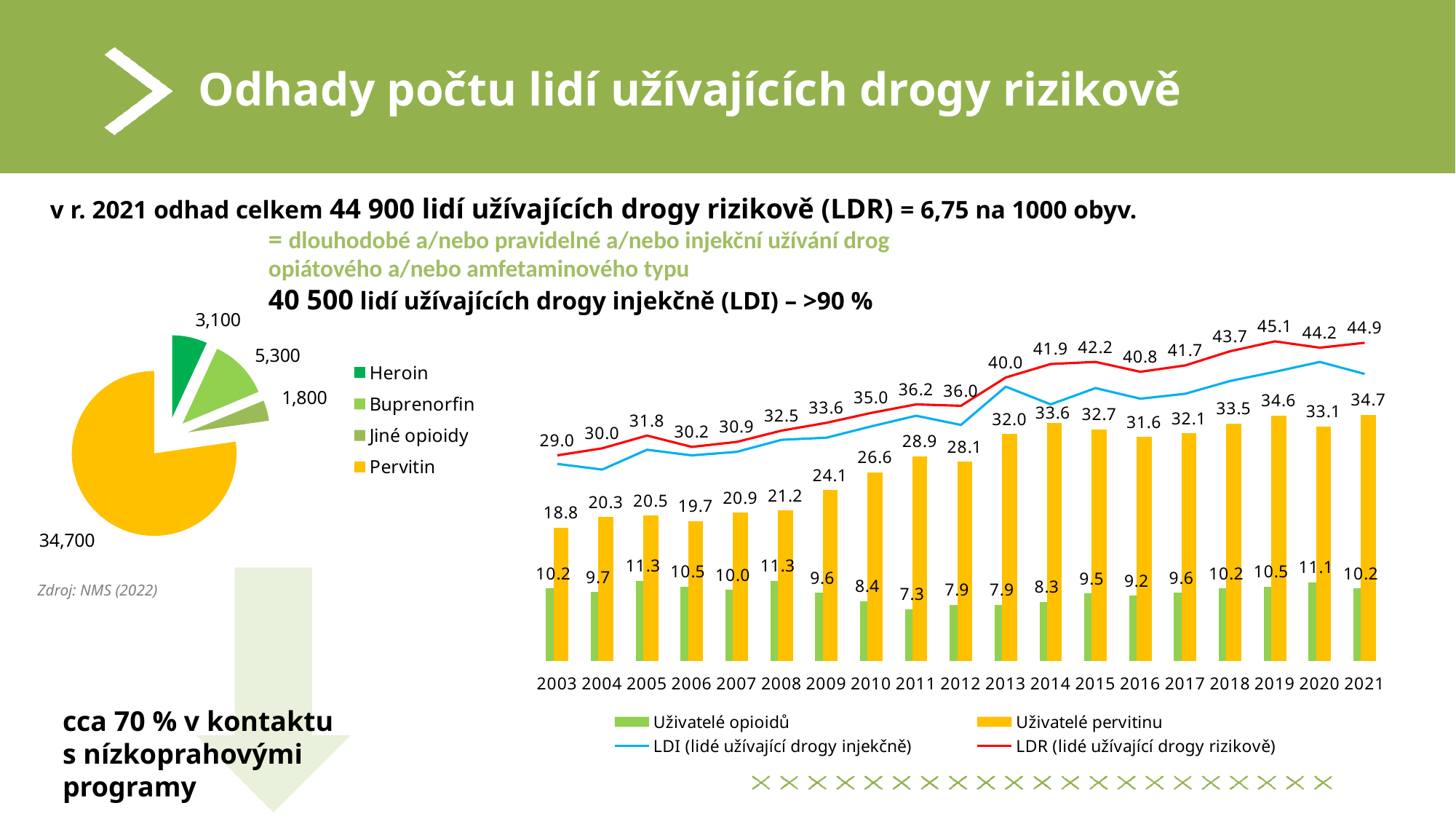
How many categories does the legend of the pie chart on the left list? 4 In the chart on the right, what is the value for Uživatelé pervitinu in 2021? 34.7 In the chart on the right, which is larger: Uživatelé pervitinu in 2003 or in 2013? 2013 In the chart on the right, what is the value for Uživatelé opioidů in 2011? 7.3 In the chart on the right, what is the difference between the LDR value in 2021 and in 2003? 15.9 In the pie chart on the left, which category has the smallest value? Jiné opioidy In the pie chart on the left, what is the difference between the Buprenorfin and Heroin values? 2,200 In the pie chart on the left, what is the value for Pervitin? 34,700 How many years are shown on the x axis of the chart on the right? 19 In the chart on the right, do the Uživatelé pervitinu values generally rise or fall from 2003 to 2021? rise In the chart on the right, in which year is the LDR line at its highest? 2019 How many series does the legend of the chart on the right list? 4